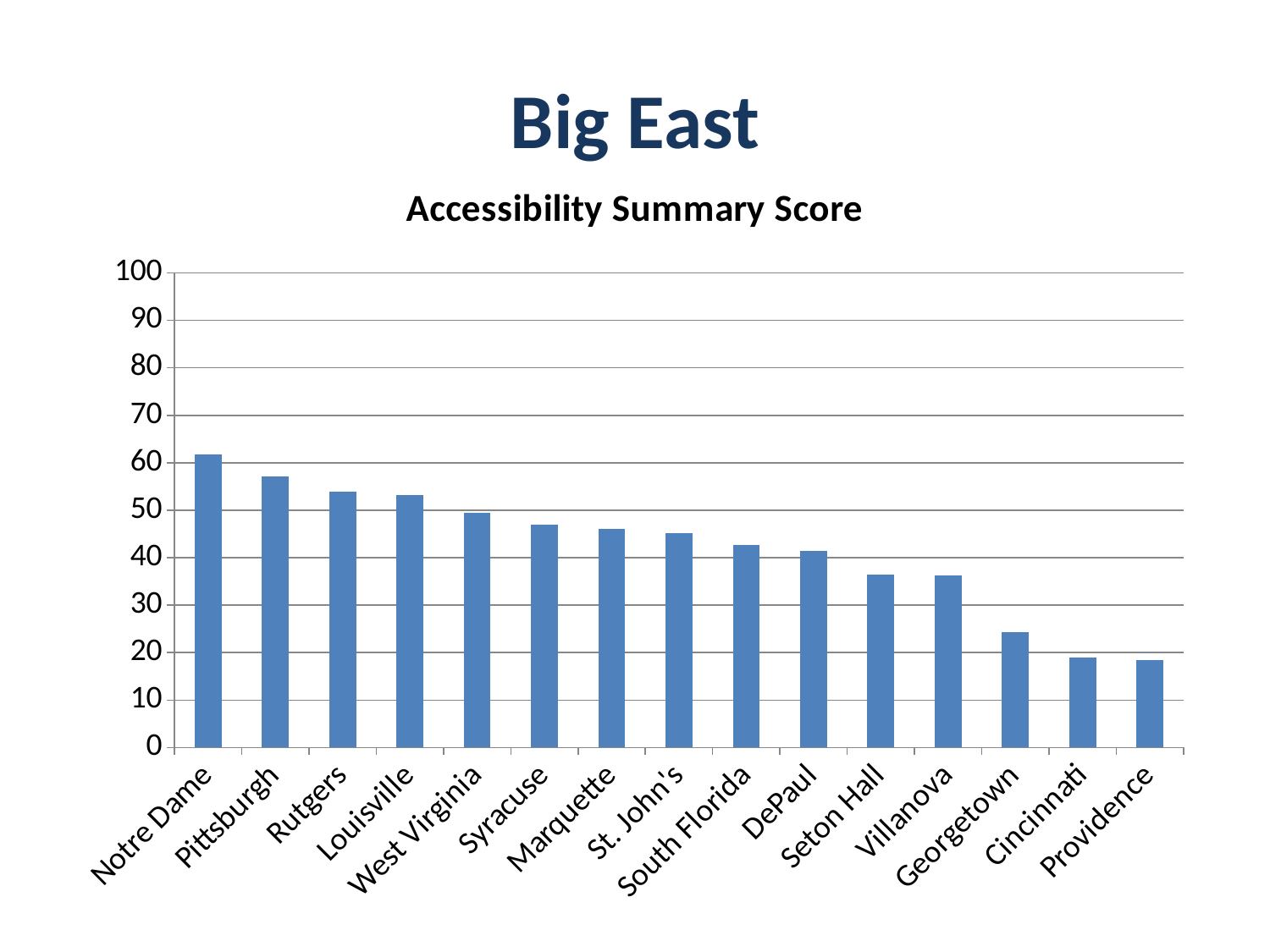
Is the value for Pittsburgh greater or less than 60? less Which school has the highest Accessibility Summary Score? Notre Dame What kind of chart is shown on the slide? bar chart Is the value for Rutgers greater or less than 50? greater How many schools are shown on the x axis of the chart? 15 Is the value for Seton Hall greater or less than 40? less What is the title of the chart? Accessibility Summary Score Which has a higher Accessibility Summary Score, Louisville or Villanova? Louisville Do the values rise or fall moving from left to right along the x axis? fall